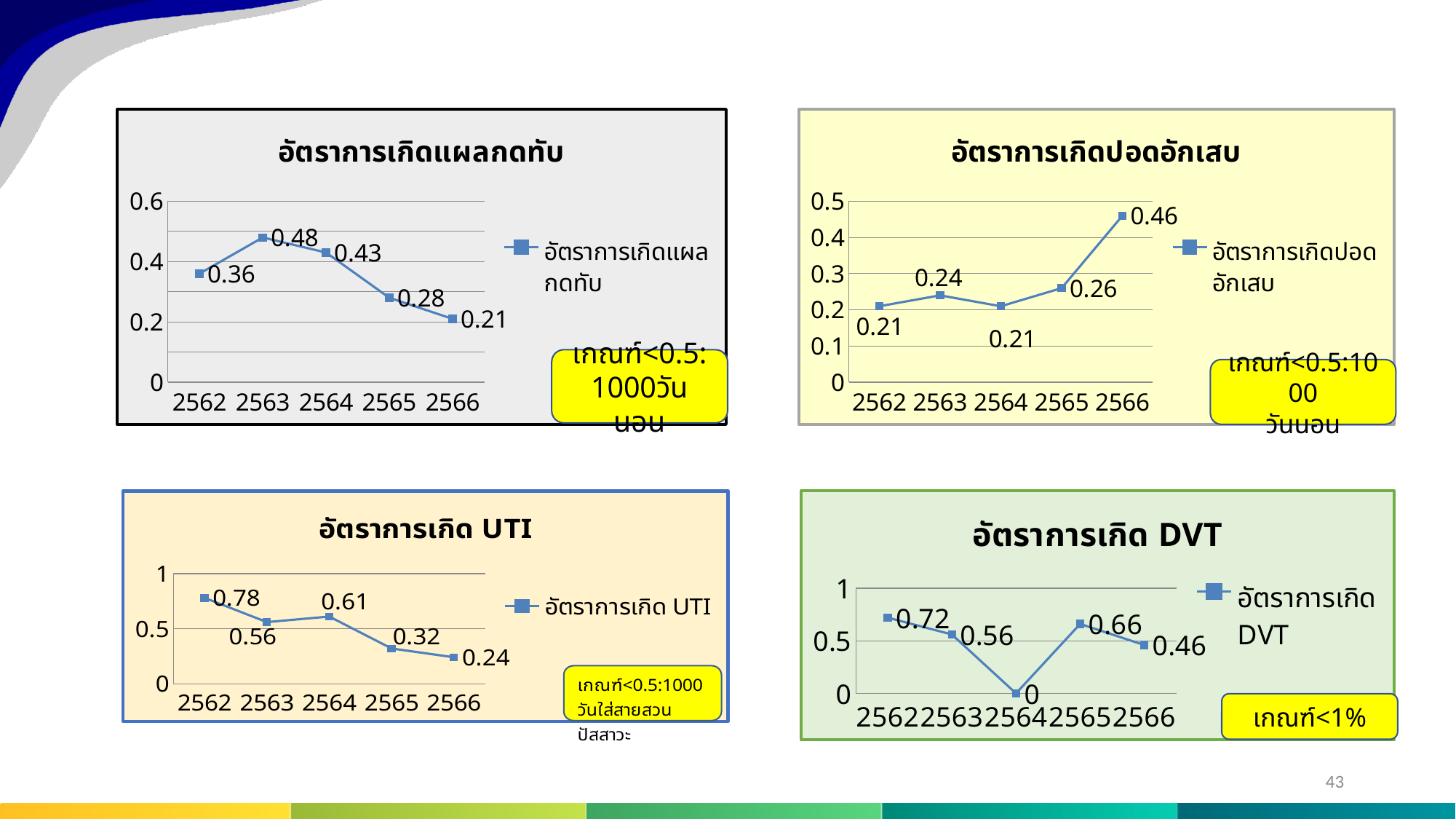
In the top-right chart (อัตราการเกิดปอดอักเสบ), what is the value for 2566? 0.46 In the top-left chart (อัตราการเกิดแผลกดทับ), what is the value for 2563? 0.48 In the bottom-right chart (อัตราการเกิด DVT), which year has the highest value? 2562 In the bottom-left chart (อัตราการเกิด UTI), what is the difference between the values for 2562 and 2566? 0.54 In the bottom-right chart (อัตราการเกิด DVT), what is the value for 2564? 0 In the bottom-left chart (อัตราการเกิด UTI), what is the value for 2562? 0.78 In the top-left chart (อัตราการเกิดแผลกดทับ), what is the difference between the values for 2563 and 2566? 0.27 What type of chart is the bottom-right chart (อัตราการเกิด DVT)? Line chart In the top-right chart (อัตราการเกิดปอดอักเสบ), which year has the highest value? 2566 In the top-right chart (อัตราการเกิดปอดอักเสบ), how many years are plotted on the x axis? 5 In the top-left chart (อัตราการเกิดแผลกดทับ), which year has the lowest value? 2566 In the bottom-left chart (อัตราการเกิด UTI), which is larger, the value for 2563 or 2564? 2564